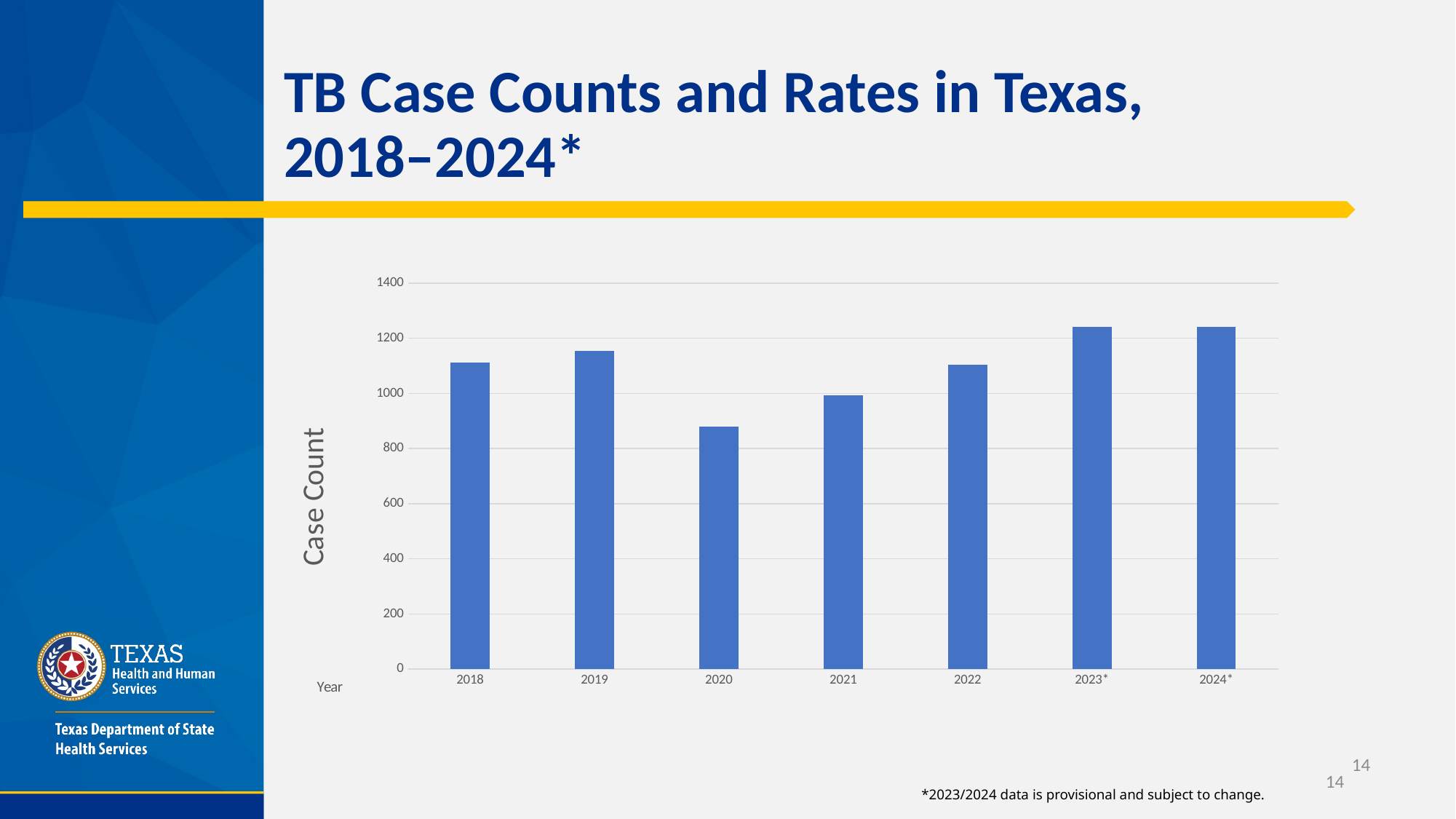
Which year has the larger case count, 2021 or 2022? 2022 What is the label on the vertical axis of the chart? Case Count Is the case count for 2023* greater or less than 1200? greater How many years (bars) are plotted in the chart? 7 What kind of chart is shown on the slide? bar chart Do the case counts rise or fall from 2020 to 2023*? rise Is the case count for 2020 greater or less than 1000? less What is the label on the horizontal axis of the chart? Year Which year has the larger case count, 2019 or 2020? 2019 Is the case count for 2021 greater or less than 1200? less Which year has the lowest case count in the chart? 2020